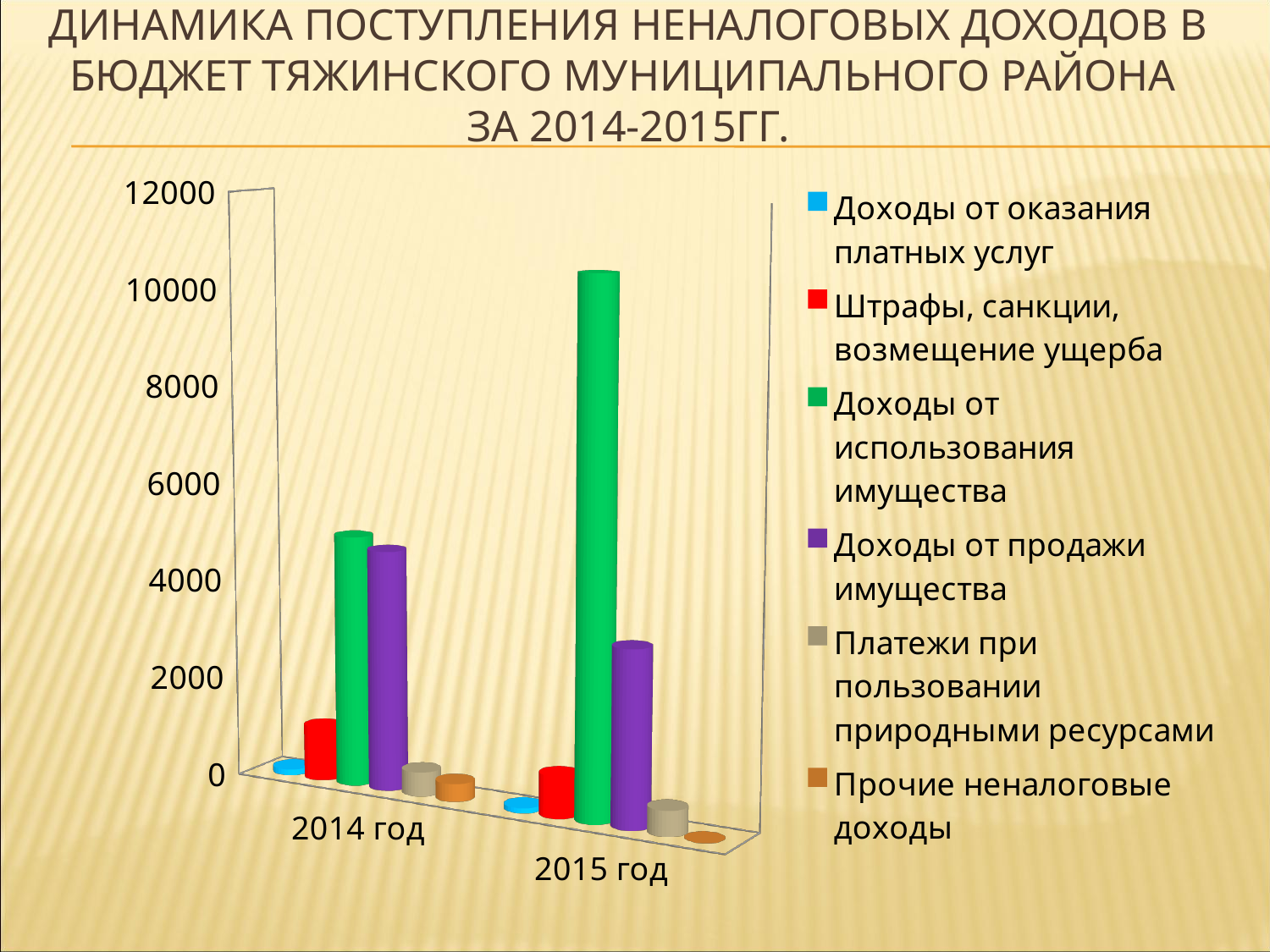
How many series does the legend list? 6 Which series has the highest value in 2015 год? Доходы от использования имущества What colour represents Доходы от использования имущества in the legend? green Which year has the larger value for Доходы от продажи имущества, 2014 год or 2015 год? 2014 год Does the value for Доходы от использования имущества rise or fall from 2014 год to 2015 год? rise Is the value for Доходы от продажи имущества in 2015 год greater or less than 4000? less Is the value for Доходы от использования имущества in 2015 год greater or less than 8000? greater Does the value for Доходы от продажи имущества rise or fall from 2014 год to 2015 год? fall How many year categories are shown on the x axis? 2 What kind of chart is shown on the slide? bar chart Is the value for Штрафы, санкции, возмещение ущерба in 2014 год greater or less than 2000? less